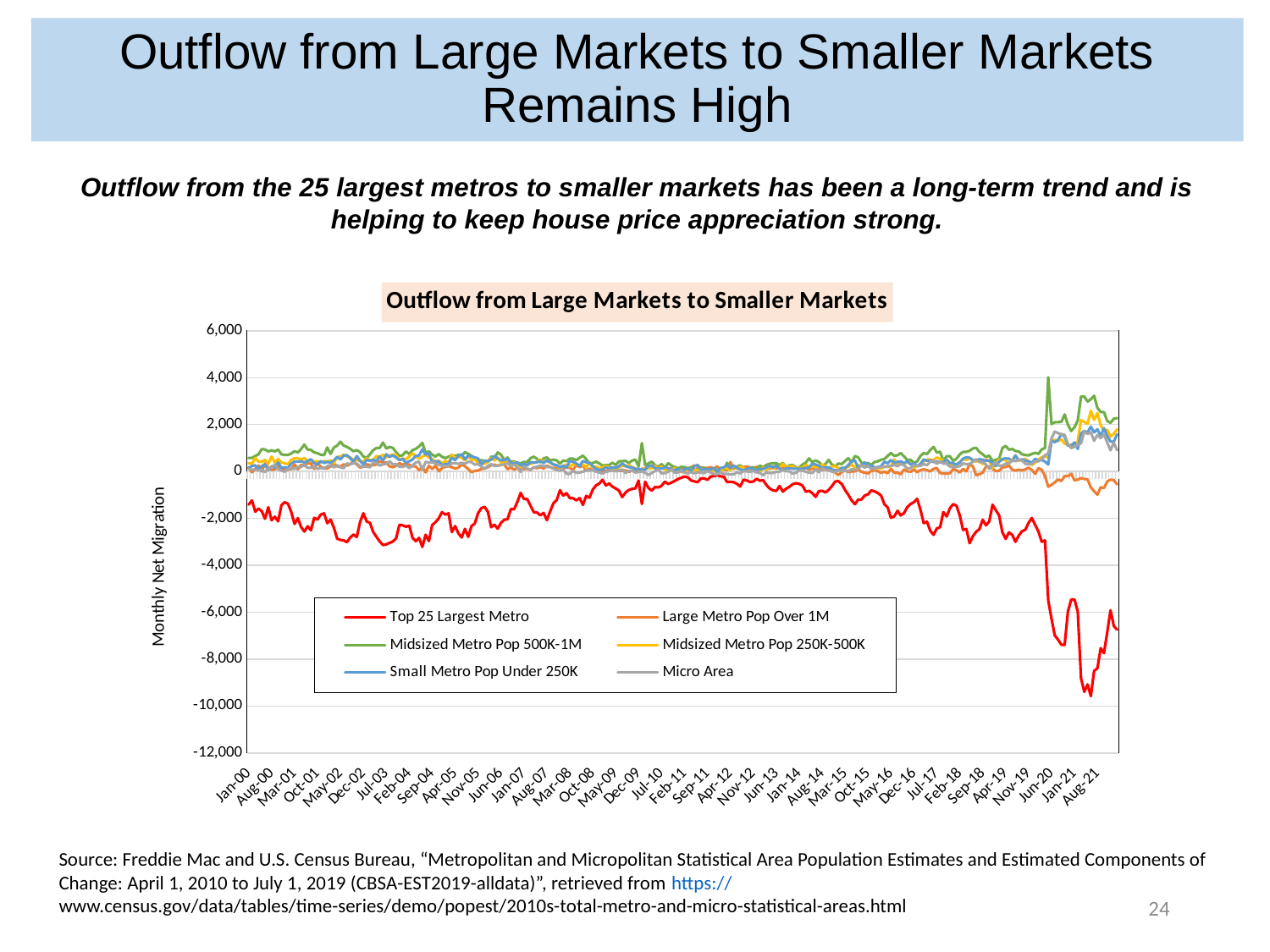
Which series is larger around Jan-21, Top 25 Largest Metro or Micro Area? Micro Area Does the Top 25 Largest Metro series rise or fall between Apr-19 and Jan-21? fall What kind of chart is shown on the slide? Line chart How many series does the chart's legend list? 6 Which series has the lowest values on the chart? Top 25 Largest Metro What is the title of the chart? Outflow from Large Markets to Smaller Markets Is the value for Top 25 Largest Metro around Jan-21 greater or less than -8,000? greater Is the peak value for Midsized Metro Pop 500K-1M around Jun-20 greater or less than 2,000? greater What is the label on the vertical axis of the chart? Monthly Net Migration Does the Top 25 Largest Metro series rise or fall between Jul-03 and Feb-11? rise Is the value for Top 25 Largest Metro around Jul-03 greater or less than -2,000? less What is the highest value shown on the vertical axis? 6,000